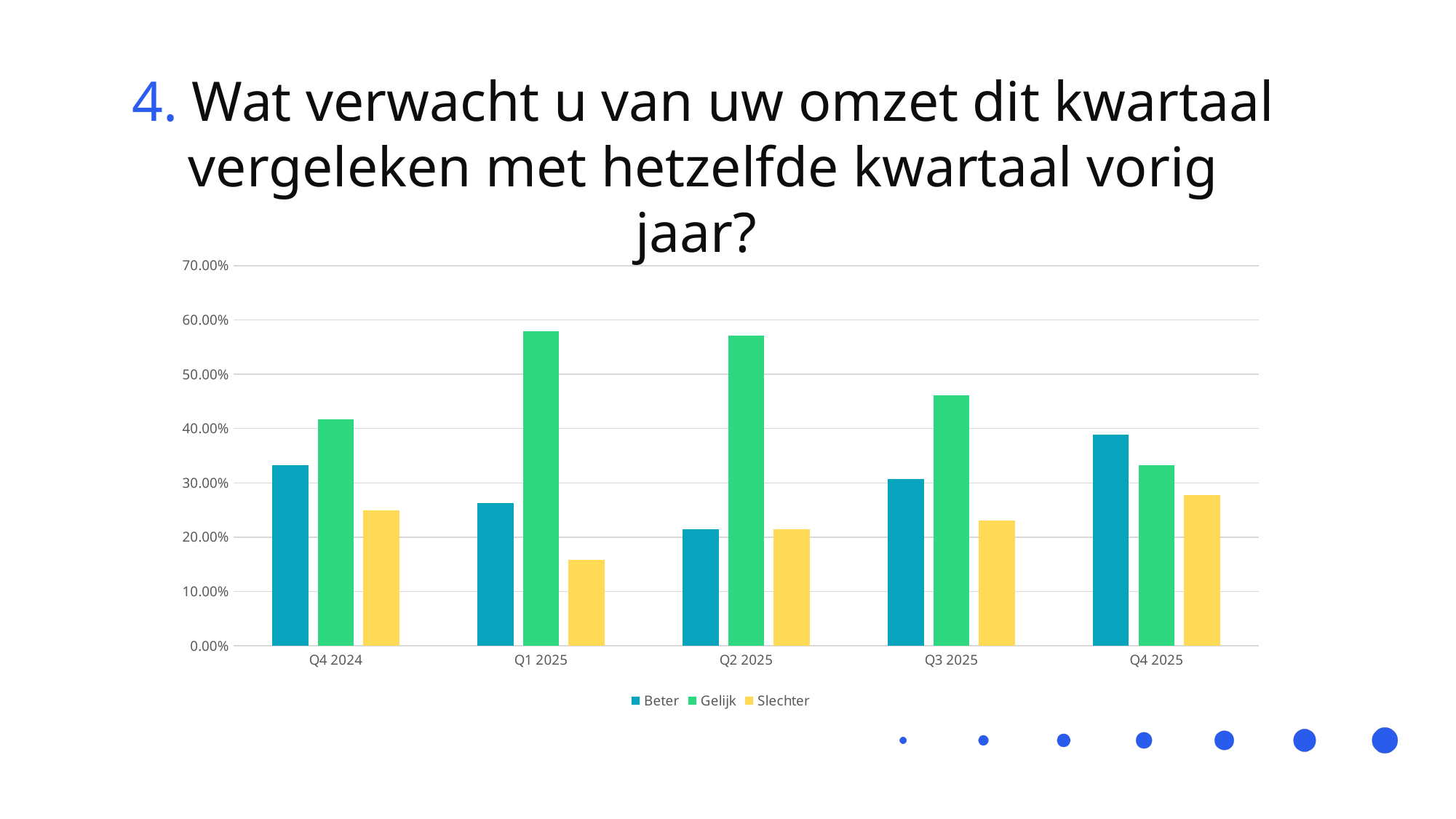
In which quarter is the Beter bar the lowest? Q2 2025 What kind of chart is shown on the slide? bar chart Which series is shown in yellow in the legend? Slechter In which quarter is the Slechter bar the lowest? Q1 2025 Is the value for Beter in Q4 2024 greater or less than 30.00%? greater Is the value for Gelijk in Q1 2025 greater or less than 50.00%? greater How many quarters are shown on the x axis? 5 How many series does the legend list? 3 Is the value for Slechter in Q1 2025 greater or less than 20.00%? less In Q4 2025, which is larger: Beter or Gelijk? Beter Does the Slechter series rise or fall from Q1 2025 to Q4 2025? rise In which quarter is the Beter bar the highest? Q4 2025